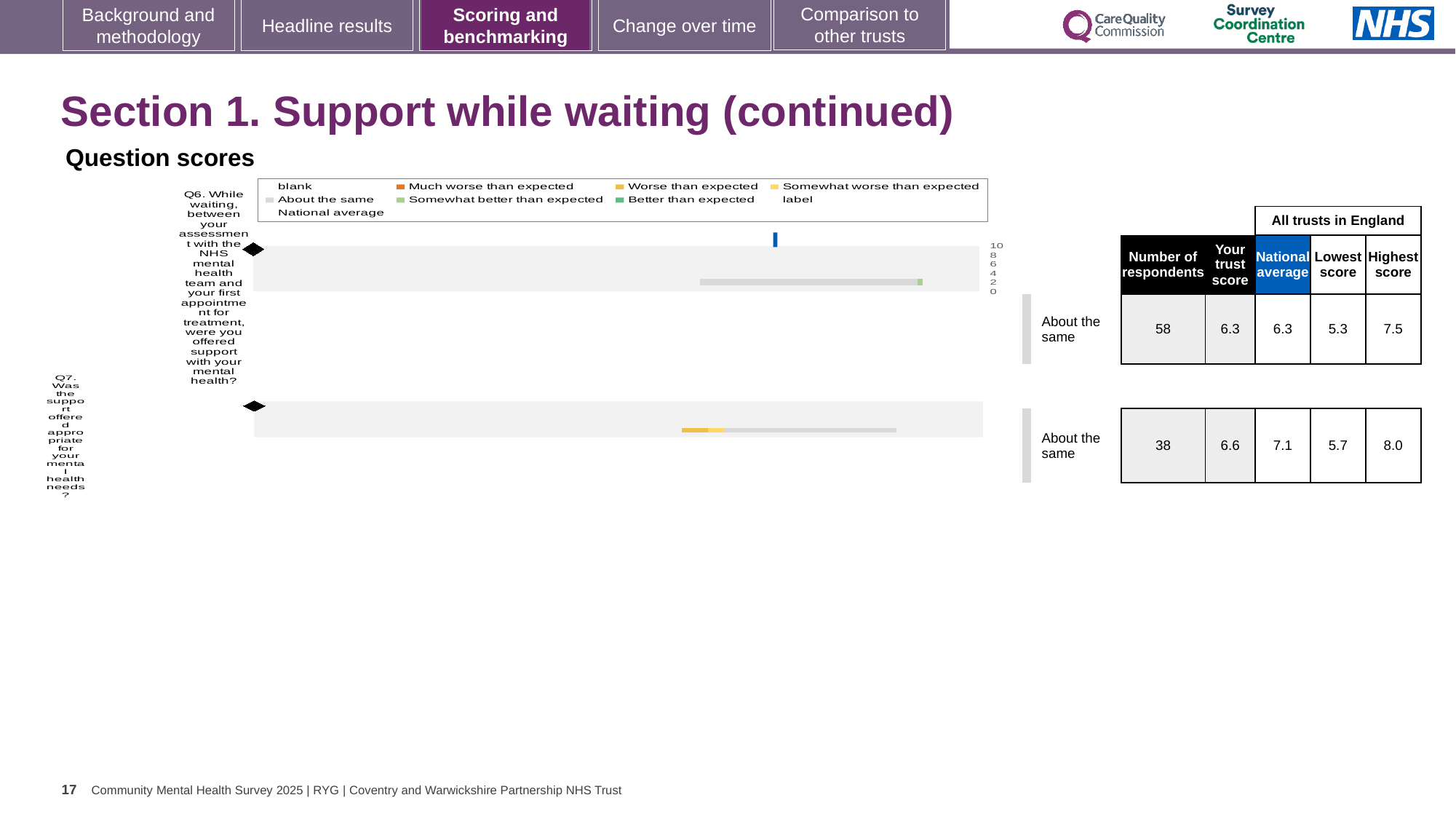
Which is larger for Q7: your trust score or the national average? national average What is the national average score for Q7? 7.1 What is the highest score among all trusts in England for Q6? 7.5 What is the highest value shown on the score axis of the Question scores chart? 10 What benchmark rating is given to Q6 in the Question scores chart? About the same What is the difference between the highest and lowest scores for Q7? 2.3 What is your trust score for Q7 (Was the support offered appropriate for your mental health needs?)? 6.6 What is the lowest score among all trusts in England for Q7? 5.7 What is the number of respondents for Q6 in the Question scores table? 58 What is the difference between the highest and lowest scores for Q6? 2.2 How many questions (categories) are plotted in the Question scores chart? 2 What kind of chart is shown under "Question scores"? bar chart